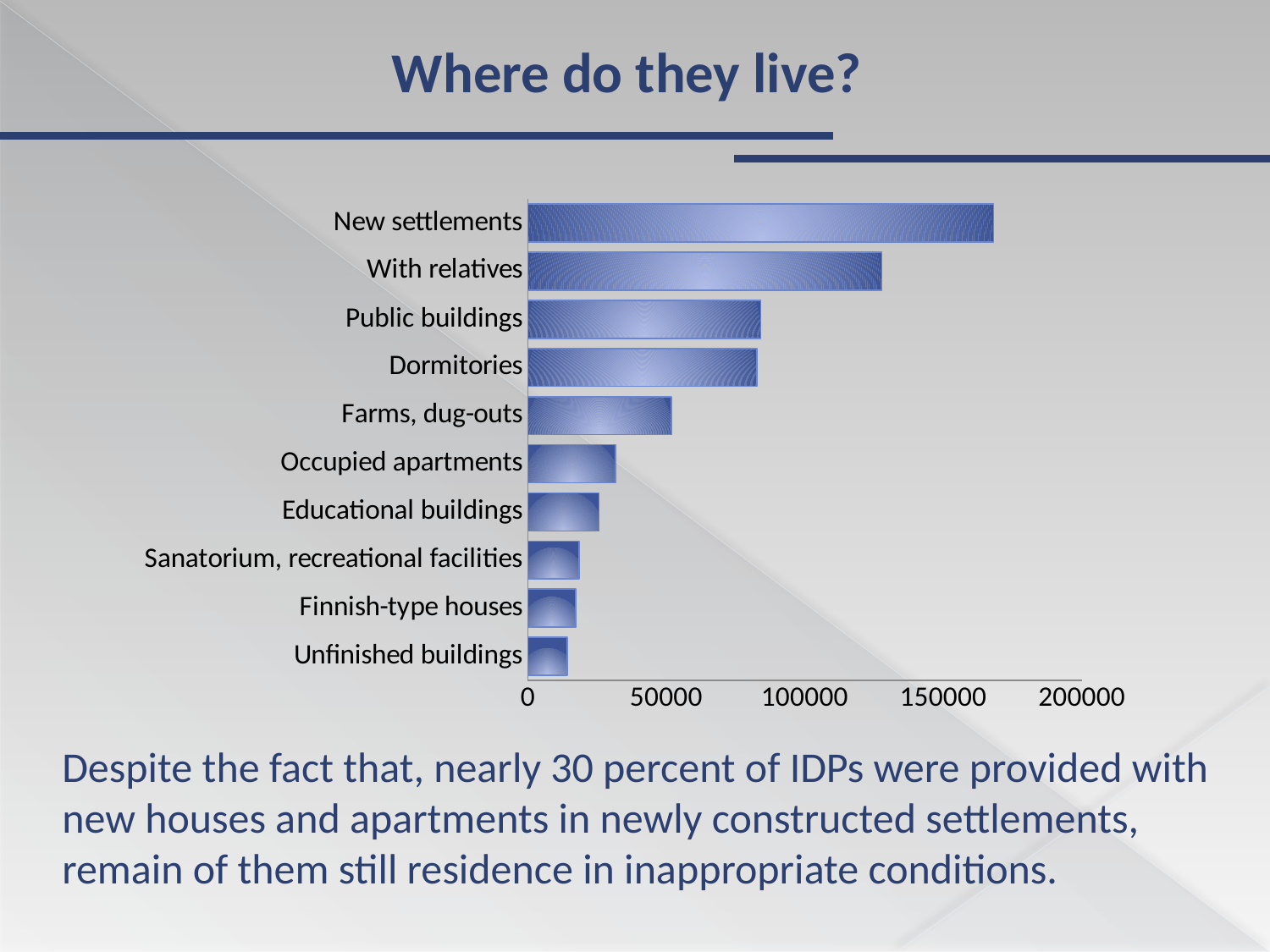
Is the value for Public buildings greater or less than 100000? less Which category has the highest value in the chart? New settlements Is the value for New settlements greater or less than 150000? greater Is the value for Occupied apartments greater or less than 50000? less Which is larger, the value for New settlements or the value for With relatives? New settlements Which is larger, the value for Farms, dug-outs or the value for Educational buildings? Farms, dug-outs What is the title of the slide containing the chart? Where do they live? What kind of chart is shown on the slide? bar chart How many categories are shown in the chart? 10